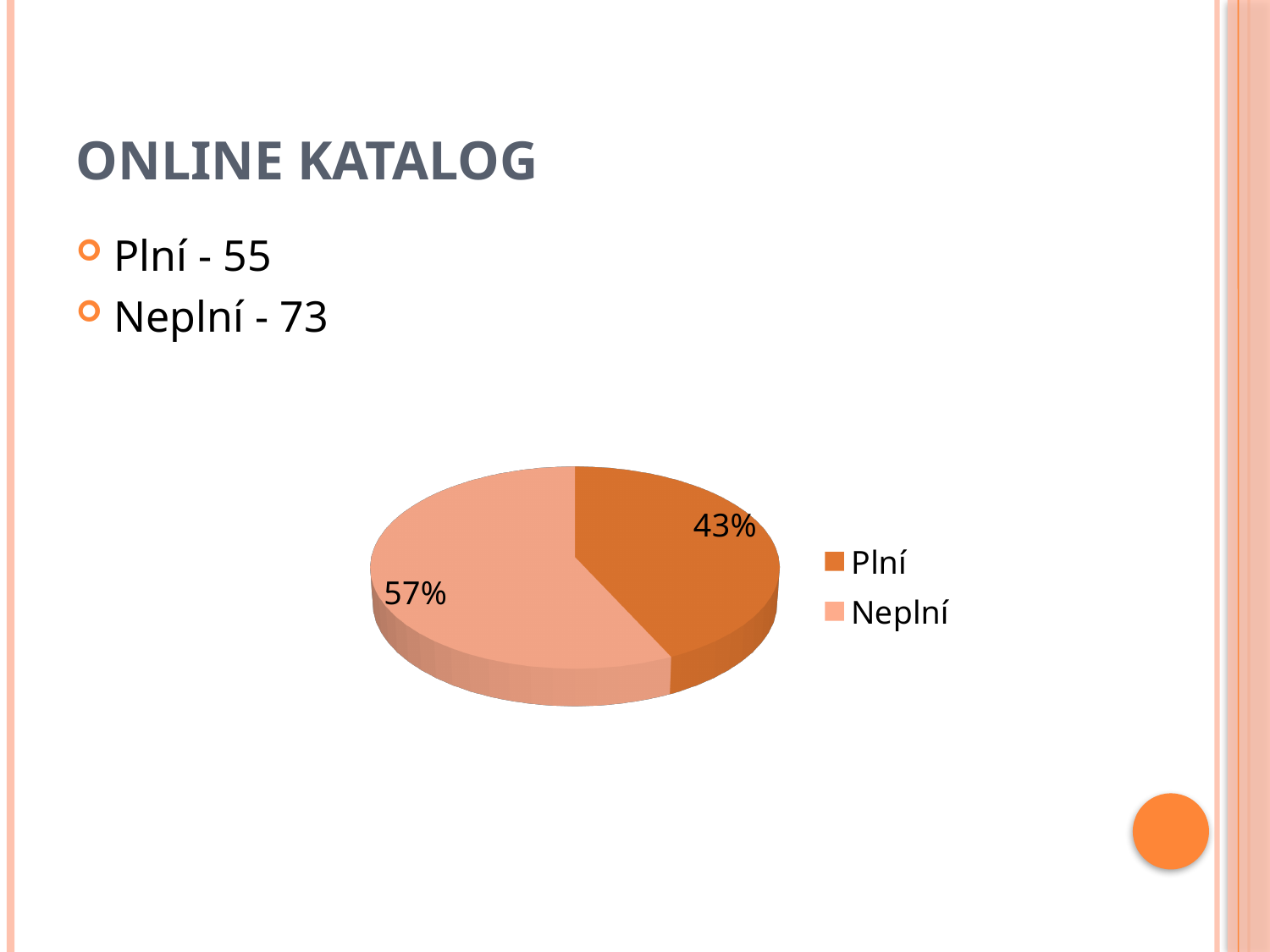
How many entries does the legend list? 2 Which legend entry is shown in the darker orange colour? Plní Which is larger, the Plní slice or the Neplní slice? Neplní What is the difference in percentage points between the Neplní and Plní slices? 14% Is the share of the Plní slice greater or less than 50%? less What percentage share does the Plní slice have? 43% What percentage share does the Neplní slice have? 57% Which slice is the smallest in the pie chart? Plní What is the title of the slide containing the pie chart? ONLINE KATALOG What kind of chart is shown on the slide? pie chart Which slice is the largest in the pie chart? Neplní How many slices does the pie chart have? 2